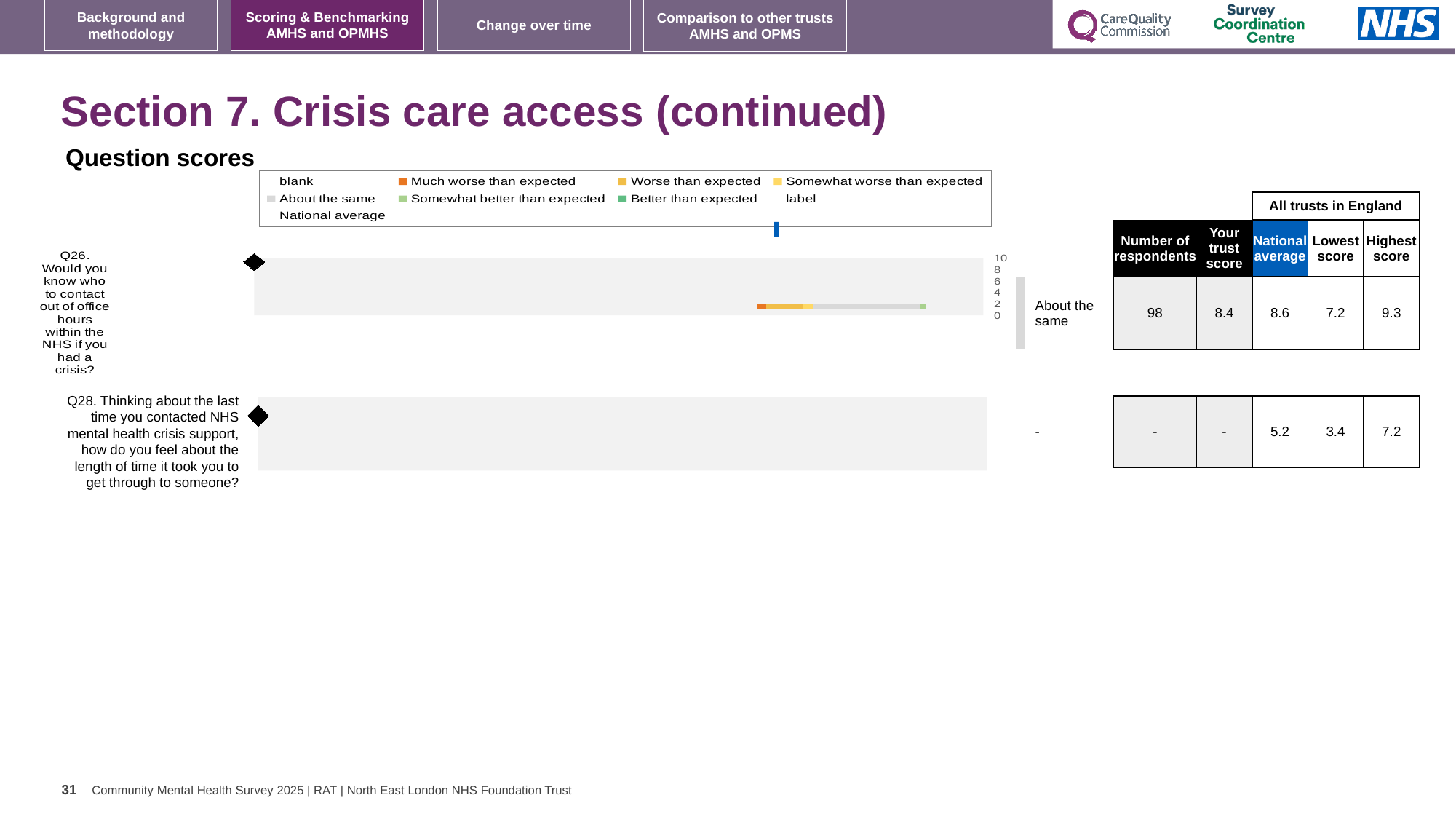
What is the trust score for Q26 (Would you know who to contact out of office hours within the NHS if you had a crisis?)? 8.4 What is the difference between the highest and lowest scores for Q26? 2.1 How many respondents answered Q26? 98 What is the lowest score among all trusts in England for Q26? 7.2 What is the lowest score among all trusts in England for Q28? 3.4 What benchmark category is shown for Q26? About the same What kind of chart is used to show the question scores on this slide? bar chart What is the highest score among all trusts in England for Q26? 9.3 For Q26, which is larger: the trust score or the national average? national average What is the national average score for Q28 (length of time it took to get through to someone)? 5.2 What is the national average score for Q26? 8.6 How many questions are plotted in the question scores chart? 2